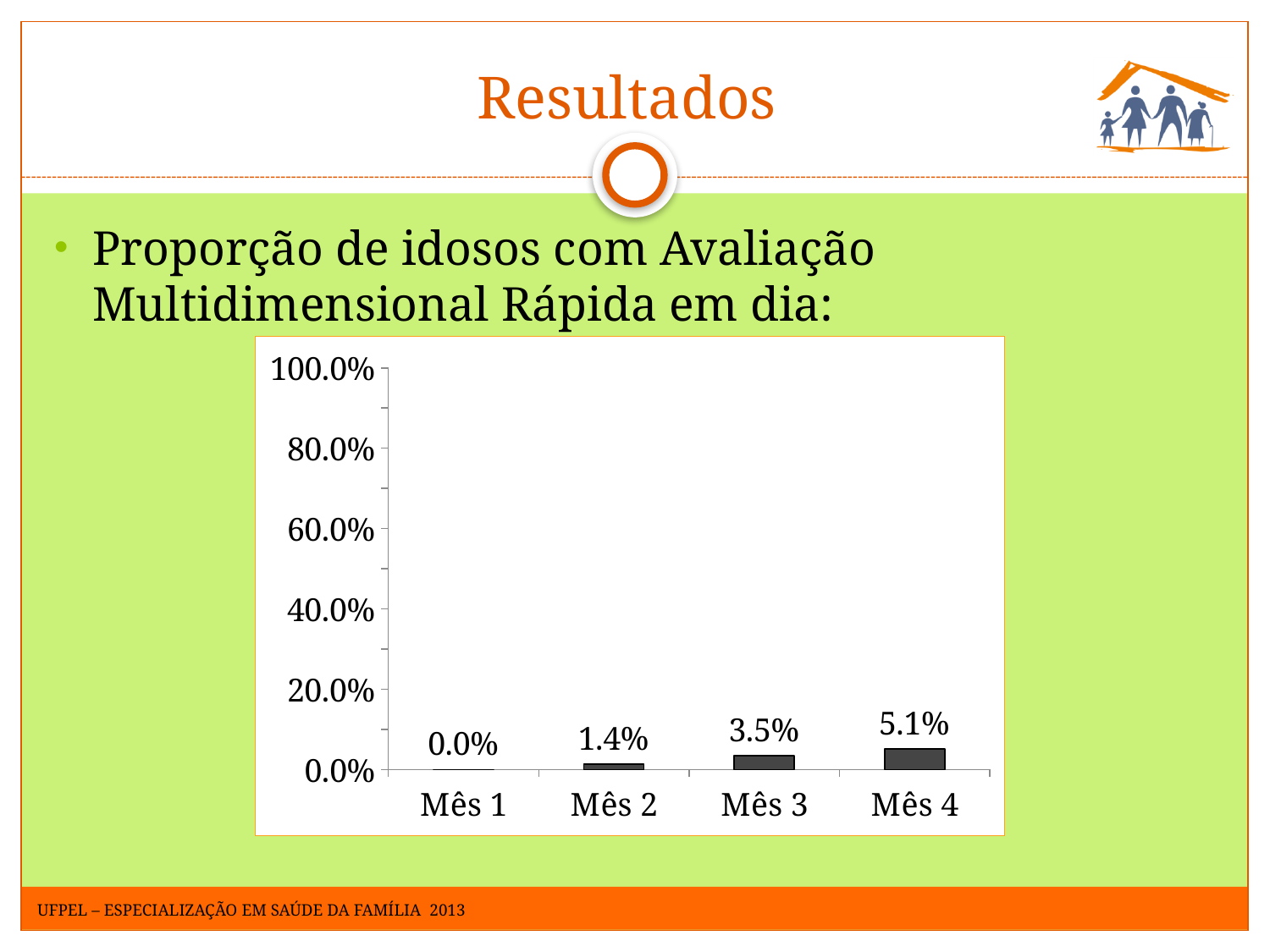
What kind of chart is shown on the slide? bar chart What is the value for Mês 3? 3.5% What is the difference between the values for Mês 4 and Mês 3? 1.6% What is the value for Mês 1? 0.0% Which month has the highest value? Mês 4 How many months are shown on the x axis? 4 What is the difference between the values for Mês 3 and Mês 2? 2.1% What is the value for Mês 2? 1.4% Is the value for Mês 4 greater or less than 20.0%? less Which month has the lowest value? Mês 1 What is the value for Mês 4? 5.1% Which is larger, the value for Mês 2 or the value for Mês 3? Mês 3